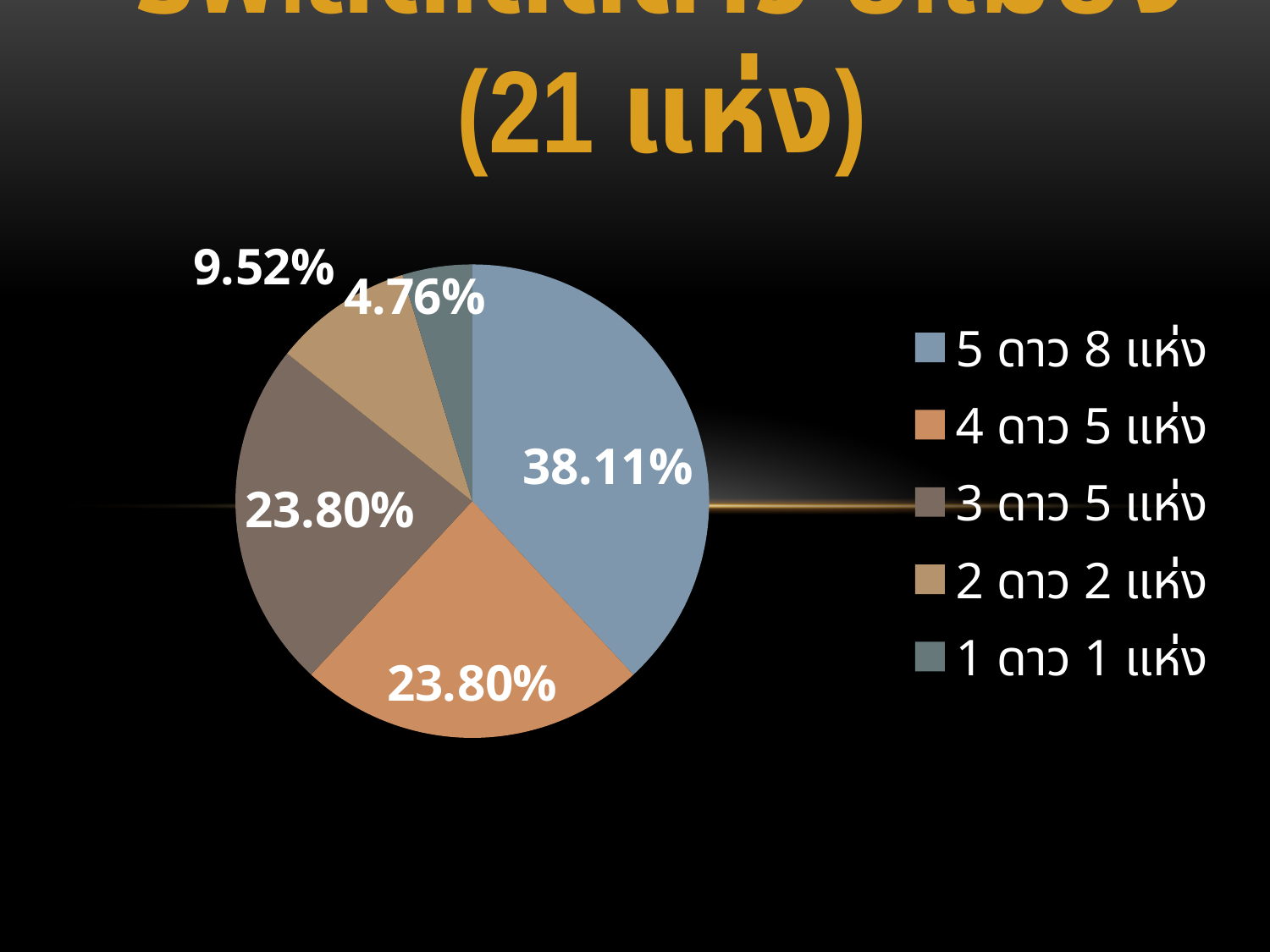
What percentage is shown for the 2 ดาว 2 แห่ง slice? 9.52% Which slice is larger, 5 ดาว 8 แห่ง or 3 ดาว 5 แห่ง? 5 ดาว 8 แห่ง What percentage is shown for the 5 ดาว 8 แห่ง slice? 38.11% What kind of chart is shown on the slide? pie chart What is the difference in percentage points between the 5 ดาว 8 แห่ง slice and the 4 ดาว 5 แห่ง slice? 14.31% What percentage is shown for the 4 ดาว 5 แห่ง slice? 23.80% How many slices does the pie chart have? 5 Which category has the smallest slice of the pie? 1 ดาว 1 แห่ง What is the difference in percentage points between the 2 ดาว 2 แห่ง slice and the 1 ดาว 1 แห่ง slice? 4.76% How many entries does the legend list? 5 Which category has the largest slice of the pie? 5 ดาว 8 แห่ง What percentage is shown for the 1 ดาว 1 แห่ง slice? 4.76%